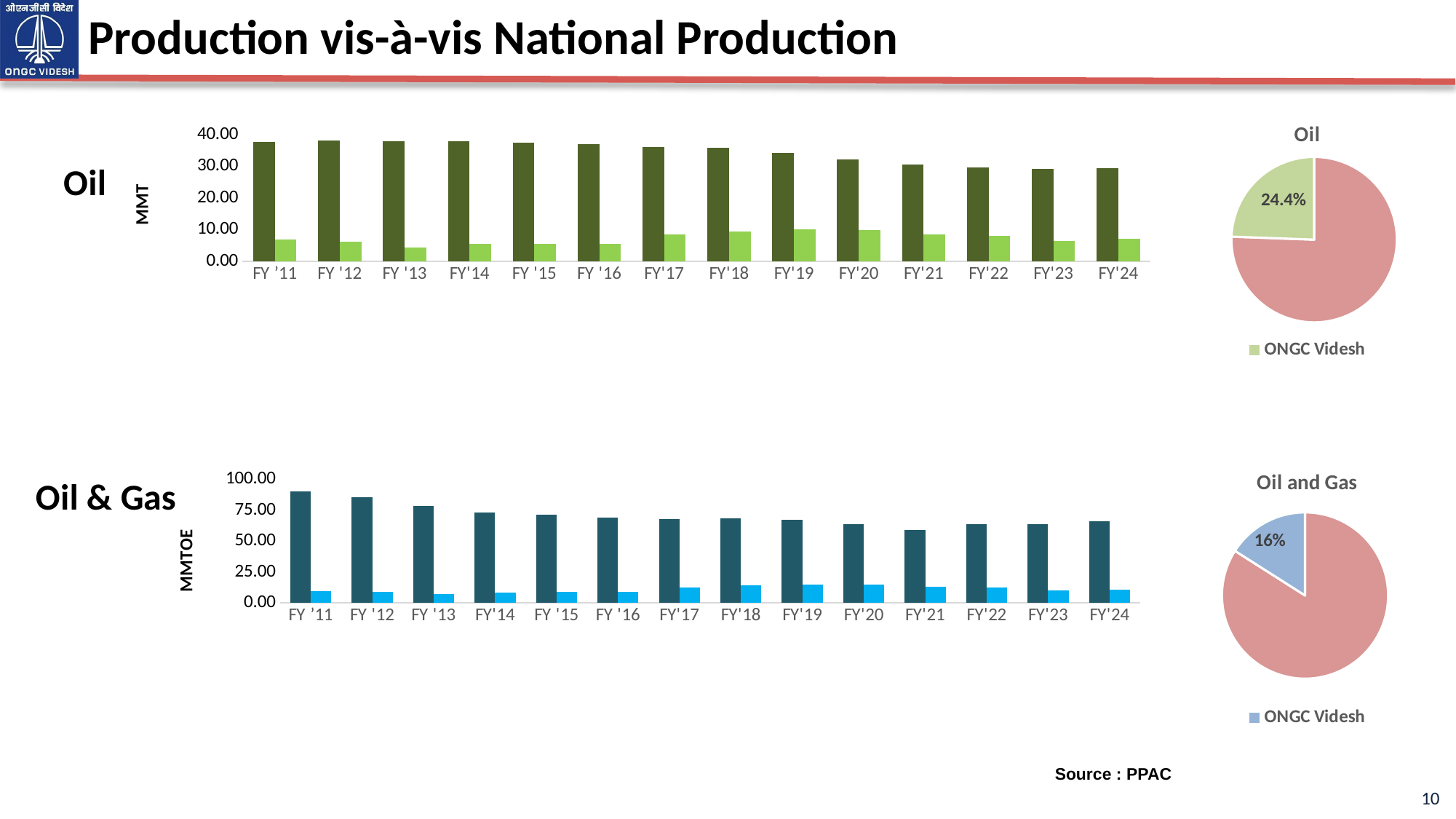
What unit is shown on the y axis of the Oil & Gas bar chart? MMTOE In the Oil & Gas bar chart, is the value of the dark bar for FY'24 greater or less than 75.00? less In the Oil bar chart, is the value of the dark green bar for FY '11 greater or less than 30.00? greater What kind of chart is the Oil & Gas chart on the left of the slide? Bar chart In the Oil bar chart, how many fiscal years are shown on the x axis? 14 In the Oil & Gas bar chart, is the value of the dark bar for FY '11 greater or less than 75.00? greater In the Oil pie chart, what share of oil production is attributed to ONGC Videsh? 24.4% In the Oil & Gas bar chart, which fiscal year has the tallest dark bar? FY '11 In the Oil and Gas pie chart, what share is attributed to ONGC Videsh? 16% In the Oil bar chart, do the dark green bars generally rise or fall from FY '11 to FY'24? fall Which pie chart shows the larger ONGC Videsh share, Oil or Oil and Gas? Oil